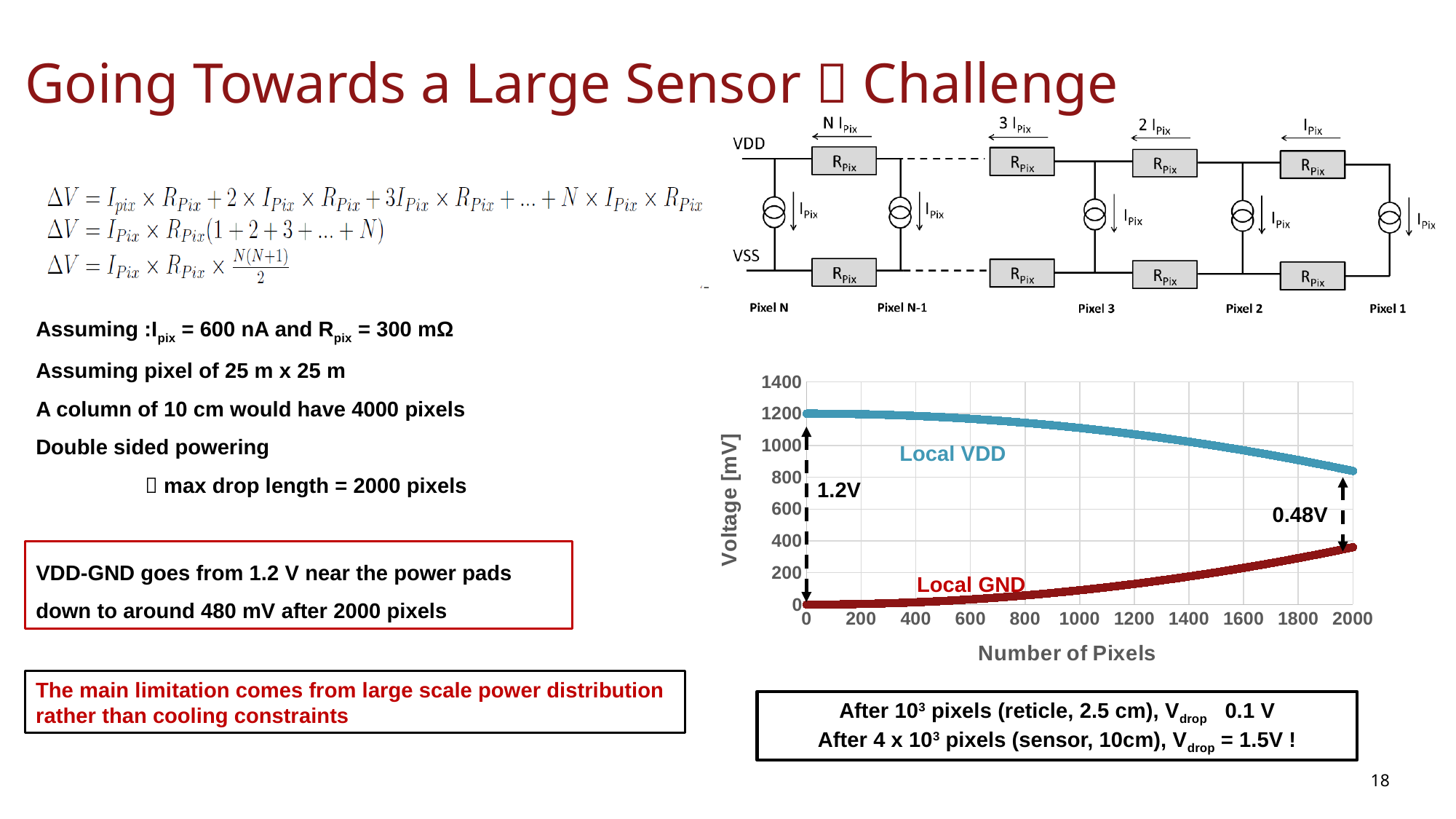
What voltage difference between Local VDD and Local GND is annotated at 0 pixels? 1.2V What is the title of the y axis of the chart? Voltage [mV] At 2000 pixels, which series has the higher value, Local VDD or Local GND? Local VDD What is the title of the x axis of the chart? Number of Pixels Is the Local VDD value at 2000 pixels greater or less than 1000? less Does the Local GND series rise or fall as the number of pixels increases? rise Is the Local VDD value at 0 pixels greater or less than 1000? greater Does the Local VDD series rise or fall as the number of pixels increases? fall Is the Local GND value at 2000 pixels greater or less than 200? greater How many series are plotted in the chart? 2 What kind of chart is shown on the slide? line chart What voltage difference between Local VDD and Local GND is annotated at 2000 pixels? 0.48V